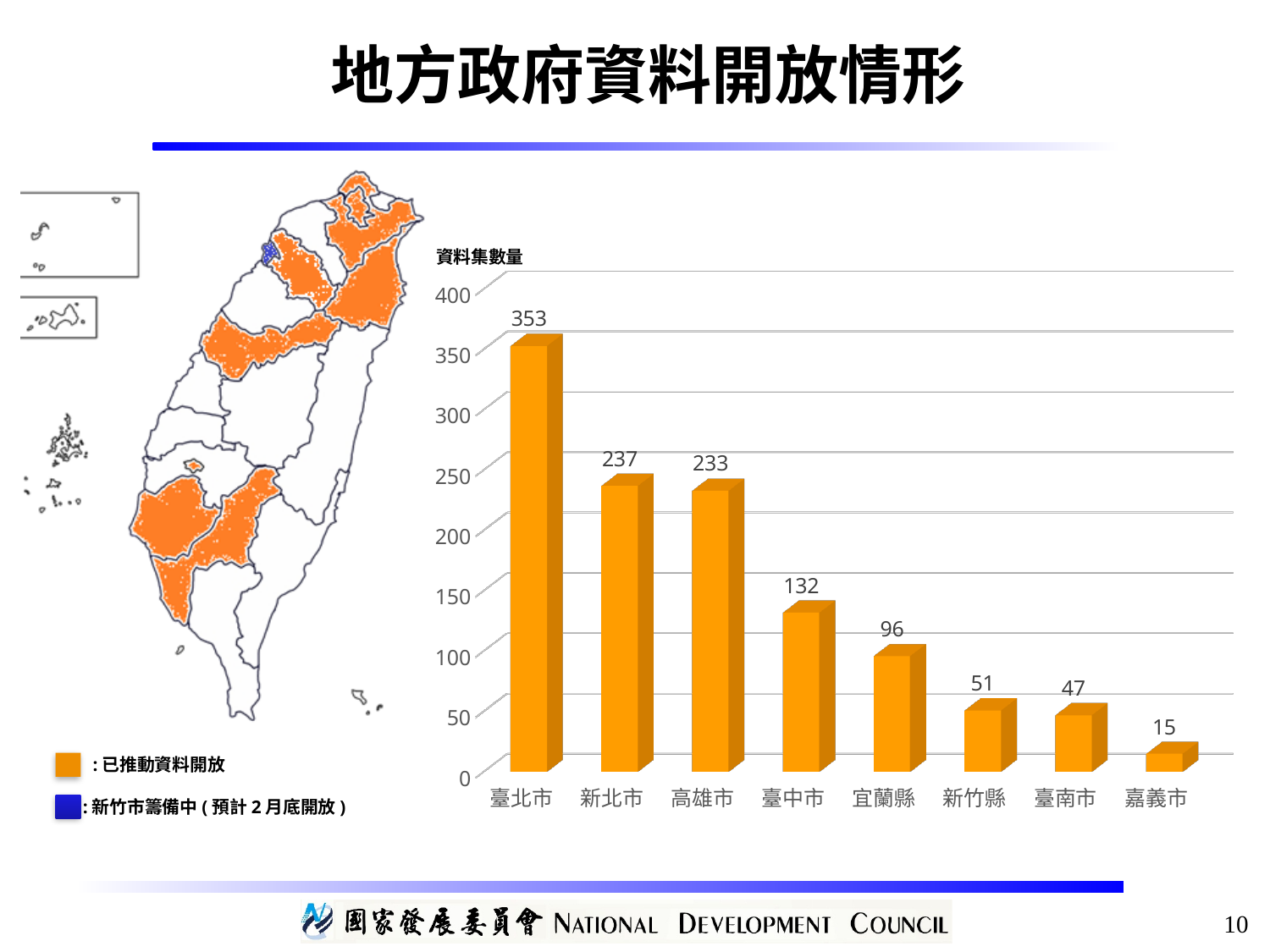
How many categories are shown on the x axis of the bar chart? 8 What is the difference between the values for 宜蘭縣 and 新竹縣? 45 Which category has the highest value in the bar chart? 臺北市 What kind of chart is shown on the slide? bar chart Is the value for 臺中市 greater or less than 100? greater Which is larger, the value for 新北市 or the value for 高雄市? 新北市 What is the label shown above the vertical axis of the bar chart? 資料集數量 What is the value for 臺中市 in the bar chart? 132 What is the value for 嘉義市 in the bar chart? 15 What is the value for 臺北市 in the bar chart? 353 What is the difference between the values for 臺北市 and 新北市? 116 Which category has the lowest value in the bar chart? 嘉義市